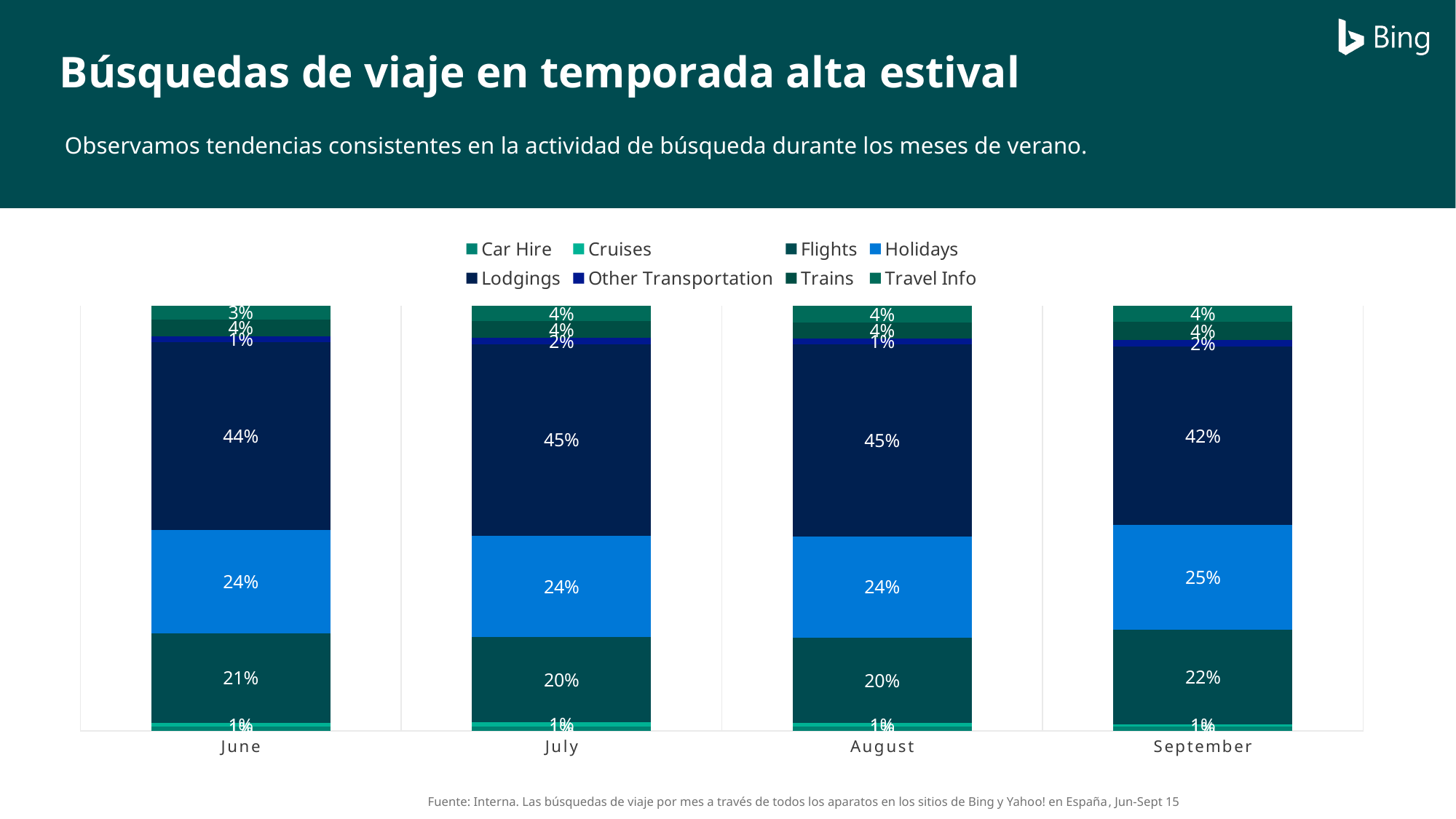
How many series does the legend list? 8 What is the Lodgings share for June? 44% In which month is the Lodgings share lowest? September What is the Holidays share for September? 25% What is the Flights share for August? 20% What is the Lodgings share for September? 42% In which month is the Flights share highest? September What kind of chart is shown on the slide? Stacked bar chart What is the difference between the Lodgings share in June and in September? 2% How many months are shown on the x axis? 4 In June, which is larger: the Holidays share or the Flights share? Holidays What is the title of the slide? Búsquedas de viaje en temporada alta estival